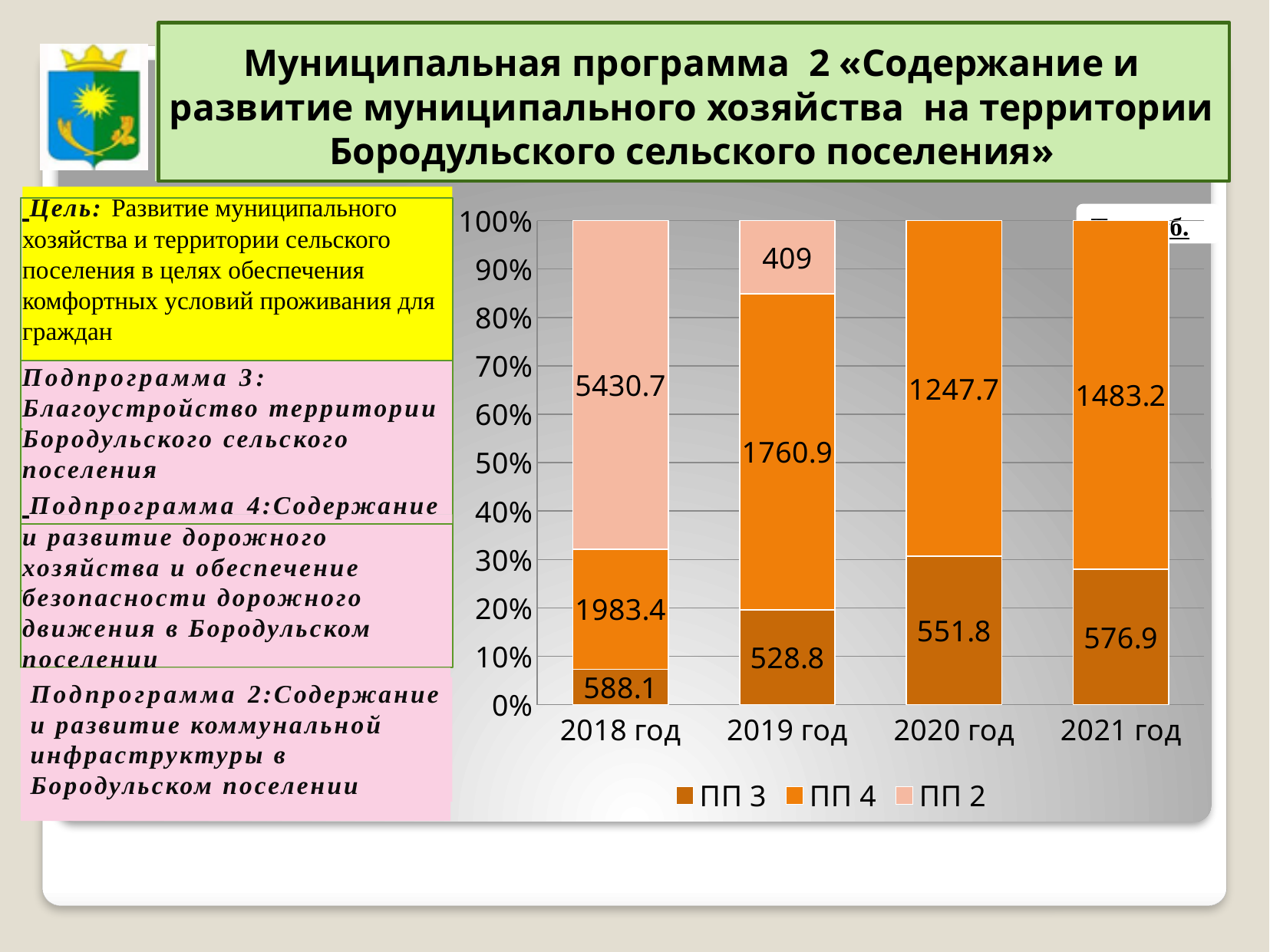
What is the value for ПП 2 in 2019 год? 409 What is the value for ПП 2 in 2018 год? 5430.7 What kind of chart is shown on the slide? stacked bar chart What is the value for ПП 4 in 2019 год? 1760.9 In which year is the value for ПП 3 the highest? 2018 год Which is larger: the ПП 3 value for 2020 год or for 2019 год? 2020 год How many series does the legend list? 3 How many year categories are shown on the x axis? 4 What is the total of the three segments in the 2019 год bar? 2698.7 In which year is the value for ПП 4 the lowest? 2020 год What is the difference between the ПП 4 values for 2021 год and 2020 год? 235.5 What is the value for ПП 3 in 2021 год? 576.9